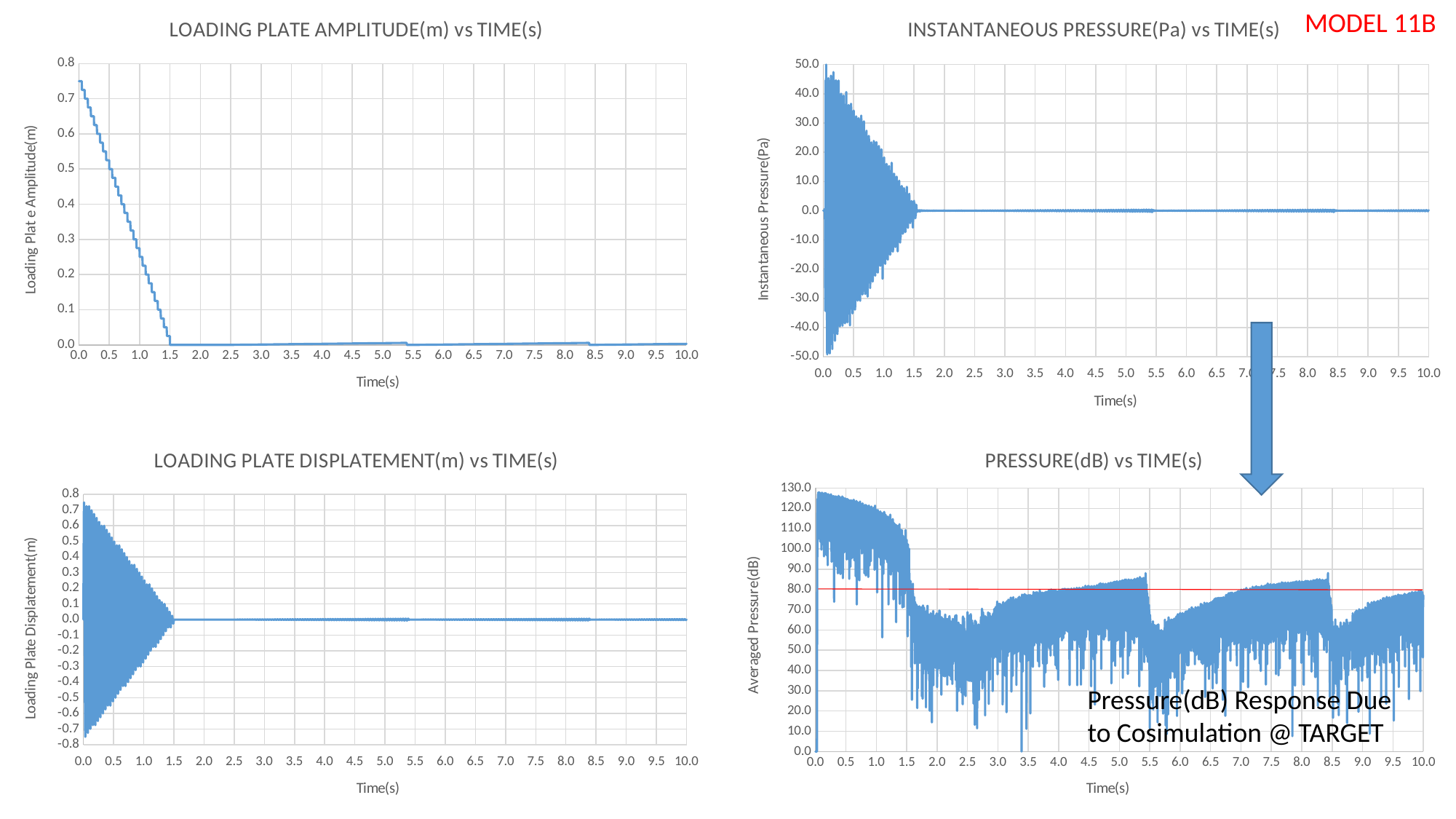
What is the y-axis label of the 'PRESSURE(dB) vs TIME(s)' chart? Averaged Pressure(dB) What kind of chart is the 'LOADING PLATE AMPLITUDE(m) vs TIME(s)' chart? line chart How many charts are shown on the slide? 4 In the 'LOADING PLATE AMPLITUDE(m) vs TIME(s)' chart, do the values rise or fall between 0.0 s and 1.5 s? fall In the 'PRESSURE(dB) vs TIME(s)' chart, is the peak value reached near time 0.0 s greater or less than 120.0? greater In the 'PRESSURE(dB) vs TIME(s)' chart, at what y-axis value is the red horizontal line drawn? 80.0 In the 'LOADING PLATE AMPLITUDE(m) vs TIME(s)' chart, is the value at time 0.0 s greater or less than 0.5? greater In the 'LOADING PLATE AMPLITUDE(m) vs TIME(s)' chart, which is larger: the value at 0.5 s or the value at 1.0 s? 0.5 s In the 'LOADING PLATE DISPLATEMENT(m) vs TIME(s)' chart, does the size of the oscillations rise or fall between 0.0 s and 1.5 s? fall In the 'LOADING PLATE AMPLITUDE(m) vs TIME(s)' chart, is the value at time 2.0 s greater or less than 0.1? less